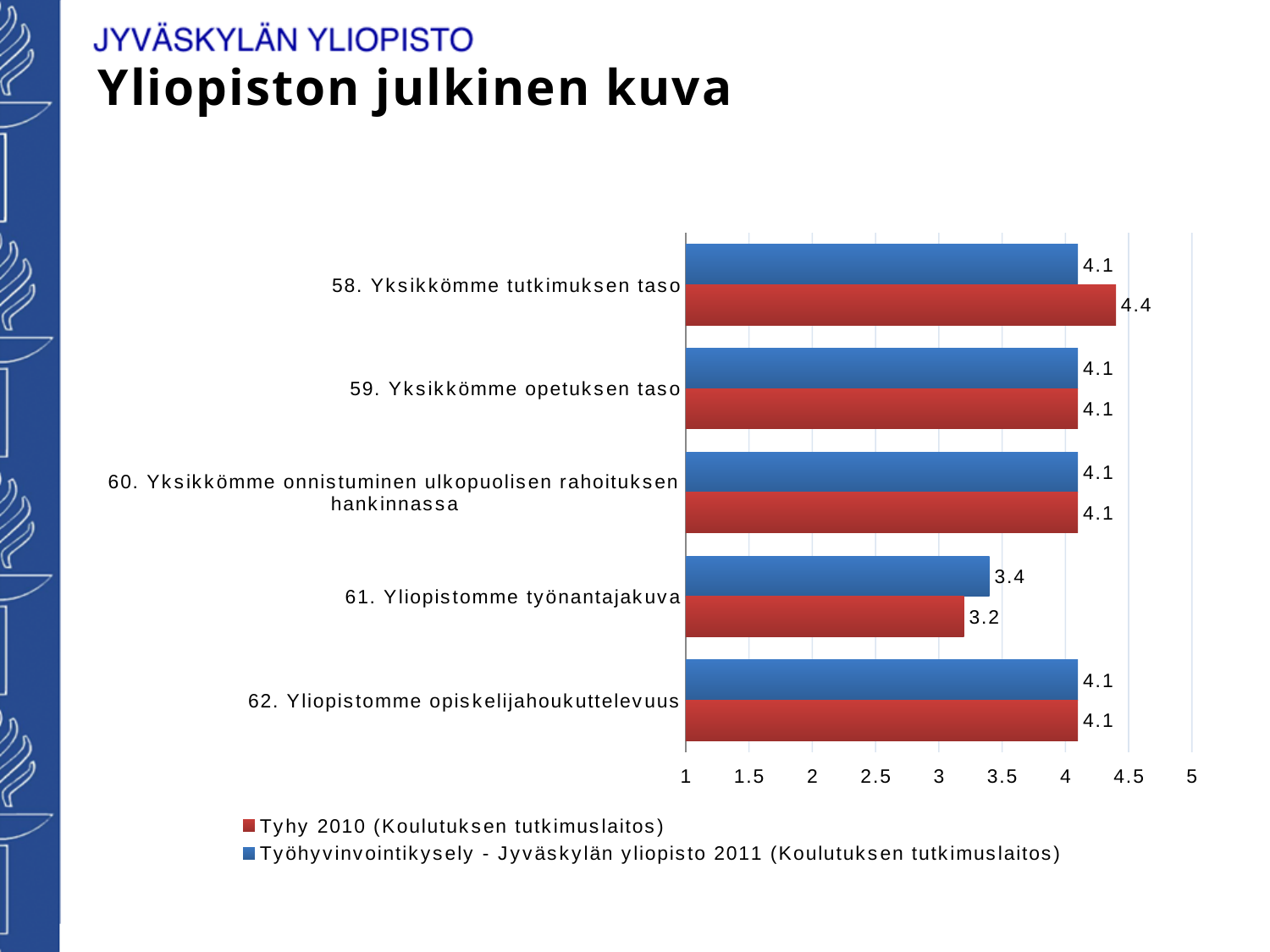
What kind of chart is shown on the slide? bar chart Which category has the highest Tyhy 2010 value? 58. Yksikkömme tutkimuksen taso How many series does the legend list? 2 For "61. Yliopistomme työnantajakuva", which series has the larger value, Tyhy 2010 or Työhyvinvointikysely 2011? Työhyvinvointikysely 2011 What is the Tyhy 2010 value for "58. Yksikkömme tutkimuksen taso"? 4.4 How many categories are shown on the chart? 5 What is the difference between the Tyhy 2010 and Työhyvinvointikysely 2011 values for "58. Yksikkömme tutkimuksen taso"? 0.3 What is the Tyhy 2010 value for "61. Yliopistomme työnantajakuva"? 3.2 Which category has the lowest Tyhy 2010 value? 61. Yliopistomme työnantajakuva Which colour represents the Tyhy 2010 series? red What is the Työhyvinvointikysely 2011 value for "61. Yliopistomme työnantajakuva"? 3.4 What is the Työhyvinvointikysely 2011 value for "62. Yliopistomme opiskelijahoukuttelevuus"? 4.1